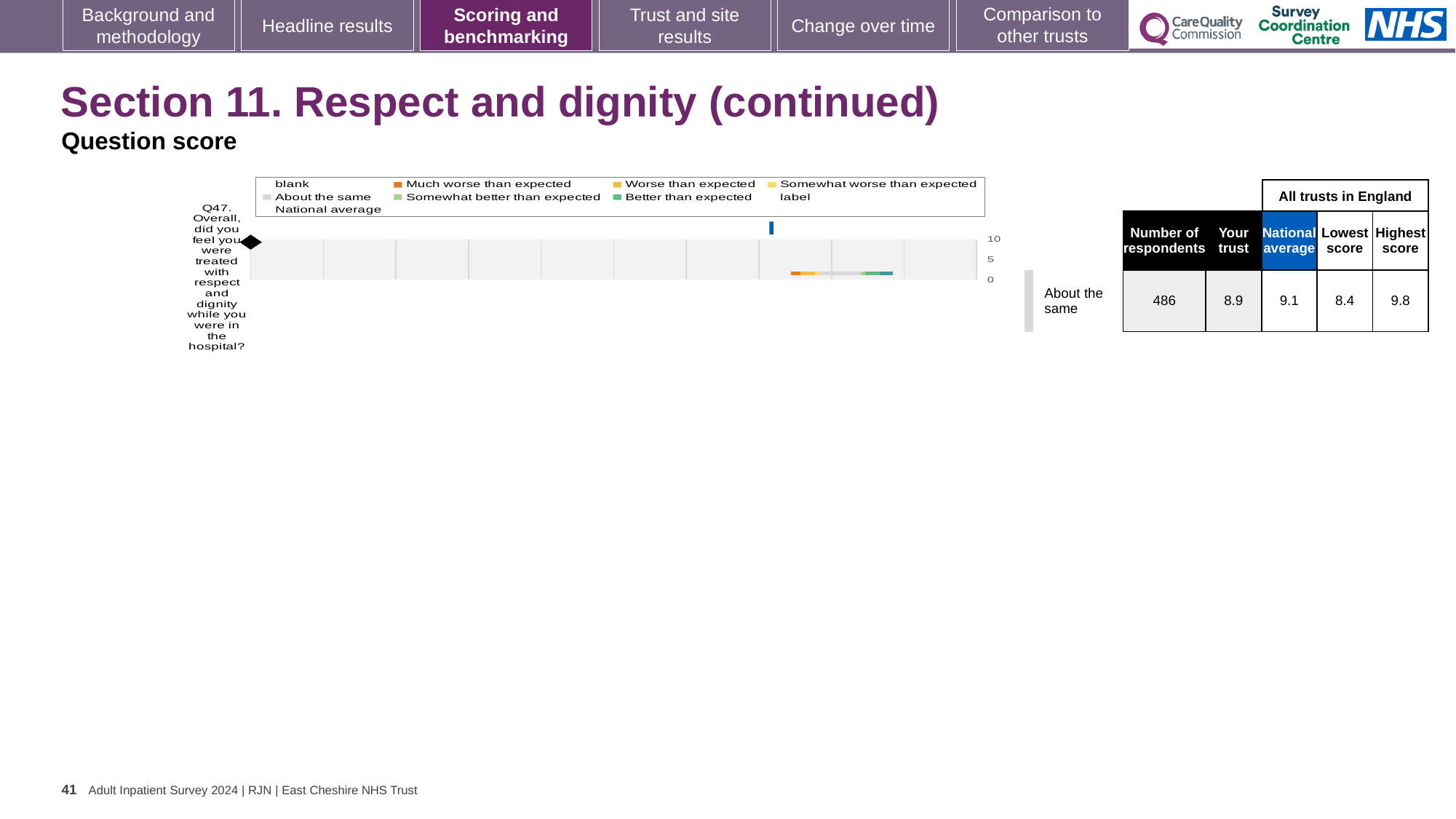
According to the table beside the chart, what is the lowest score among all trusts in England for Q47? 8.4 What is the highest tick value shown on the chart's value axis? 10 Which is larger for Q47, the 'Your trust' score or the national average? National average According to the table beside the chart, what is the 'Your trust' score for Q47? 8.9 According to the table beside the chart, what is the highest score among all trusts in England for Q47? 9.8 What is the difference between the highest score and the lowest score for Q47 in the table beside the chart? 1.4 According to the table beside the chart, what is the national average score for Q47? 9.1 Which question number is plotted on the chart? Q47 According to the table beside the chart, how many respondents answered Q47? 486 How many question categories are plotted on the chart? 1 How many entries does the chart's legend list? 9 What kind of chart is shown on the slide? bar chart